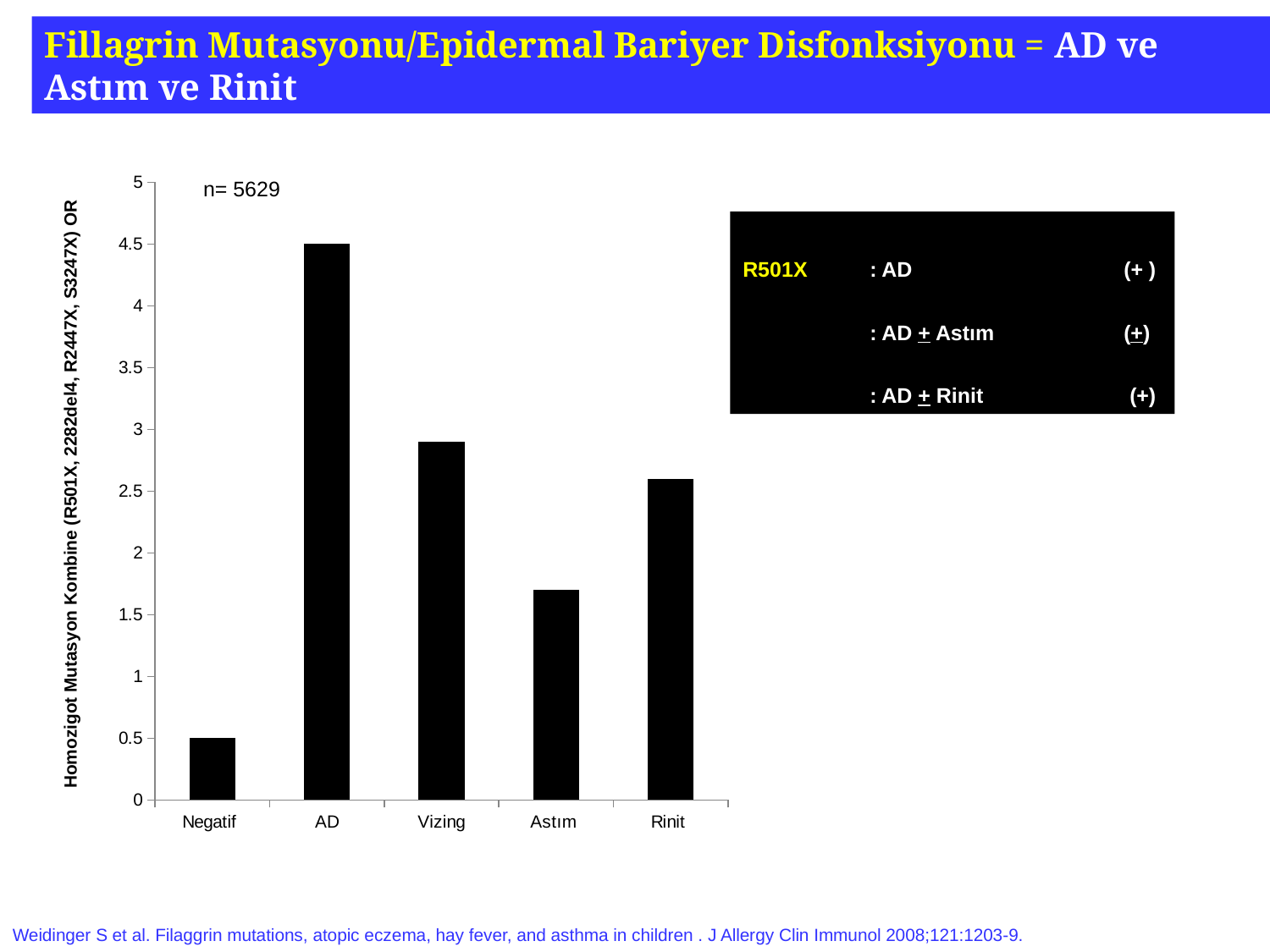
What kind of chart is shown on the slide? bar chart Which category has the lowest bar? Negatif What is the value for Negatif? 0.5 Which category has the highest bar? AD Is the value for Rinit greater or less than 2.5? greater Is the value for Astım greater or less than 1.5? greater Which is larger, the value for Vizing or the value for Astım? Vizing What is the difference between the values for AD and Negatif? 4 Is the value for Vizing greater or less than 3? less How many categories are shown on the x axis? 5 Which is larger, the value for Rinit or the value for Astım? Rinit What is the value for AD? 4.5